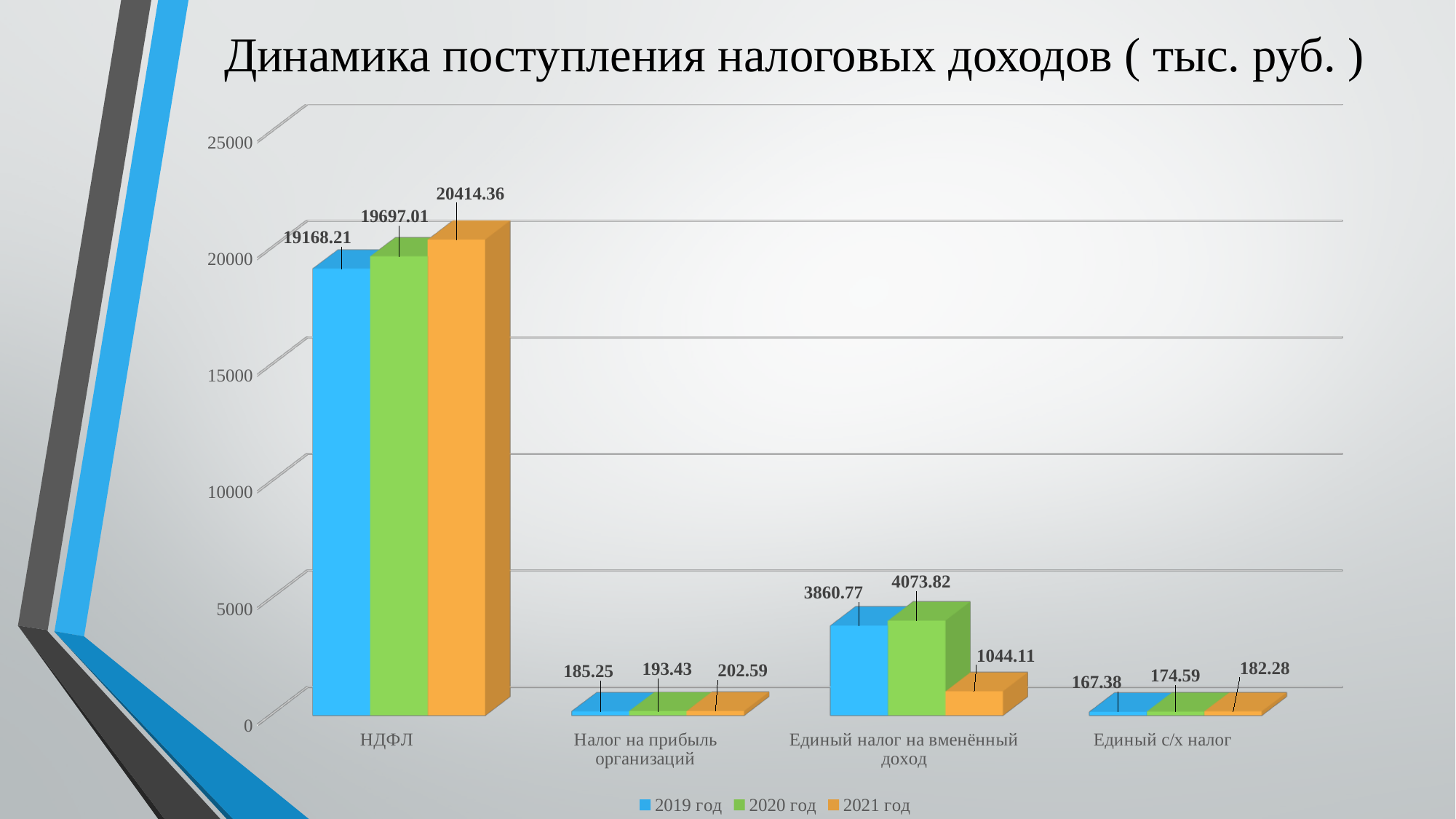
What is the difference between the 2020 год and 2021 год values for Единый налог на вменённый доход? 3029.71 How many categories are shown on the x axis? 4 Which category has the highest value in 2021 год? НДФЛ Which is larger for Единый налог на вменённый доход: the 2019 год value or the 2020 год value? 2020 год What is the value for Налог на прибыль организаций in 2020 год? 193.43 How many series does the legend list? 3 What is the difference between the 2021 год and 2019 год values for НДФЛ? 1246.15 Which category has the lowest value in 2019 год? Единый с/х налог What is the value for Единый с/х налог in 2021 год? 182.28 What kind of chart is shown on the slide? Bar chart What is the value for Единый налог на вменённый доход in 2021 год? 1044.11 What is the value for НДФЛ in 2019 год? 19168.21